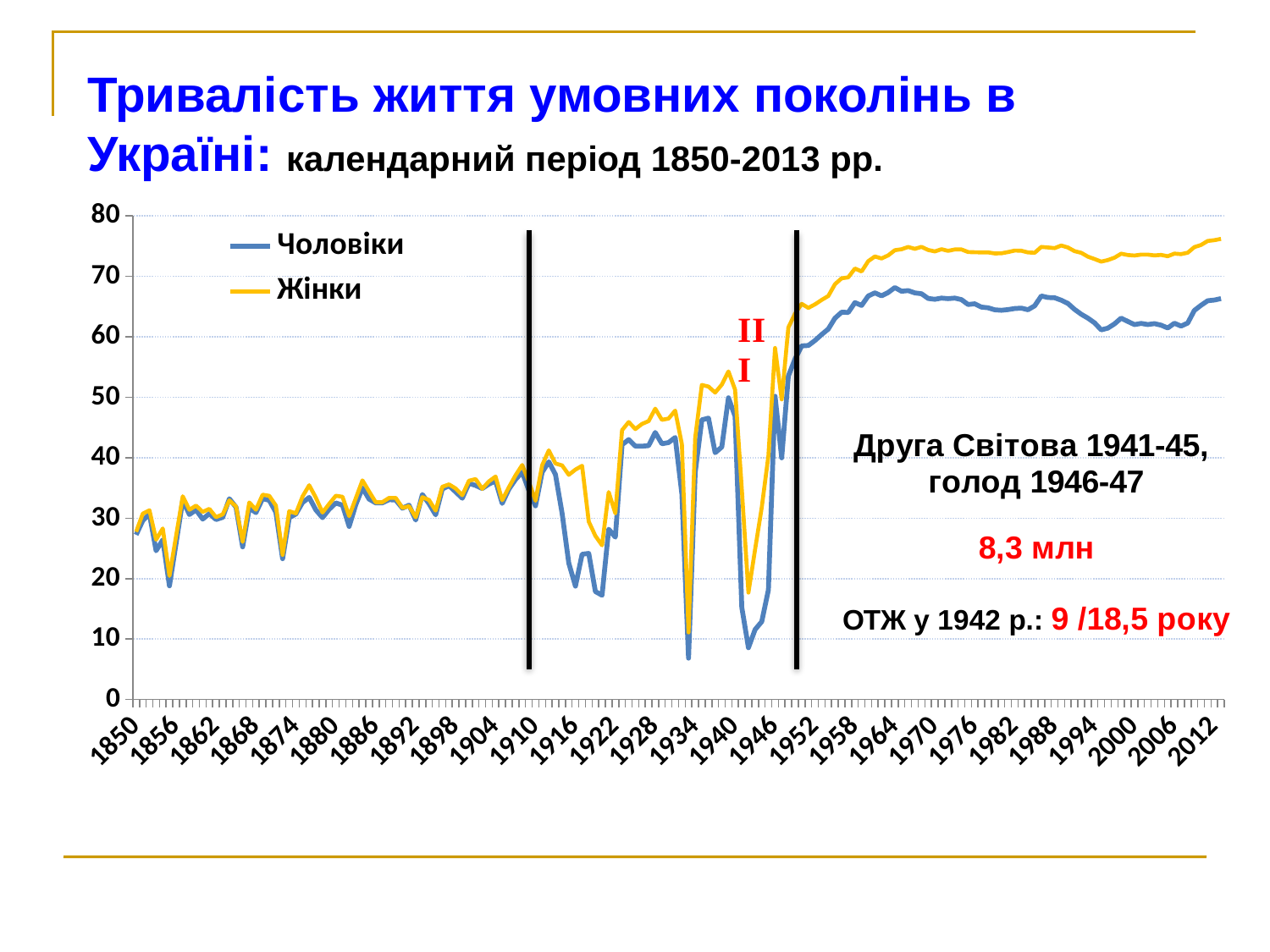
In 2012, which series has the higher value, Чоловіки or Жінки? Жінки What are the two series named in the legend? Чоловіки and Жінки How many series does the legend list? 2 Which is higher for Чоловіки: the value in 1964 or the value in 2000? 1964 Which series is drawn in yellow? Жінки According to the annotation on the chart, what was ОТЖ in 1942? 9 /18,5 року What kind of chart is shown on the slide? line chart Is the lowest value of Чоловіки in the early 1930s greater or less than 10? less Is the value for Жінки in 1964 greater or less than 70? greater Between 1952 and 1964, does the Чоловіки line rise or fall? rise Is the value for Жінки in 2012 greater or less than 70? greater